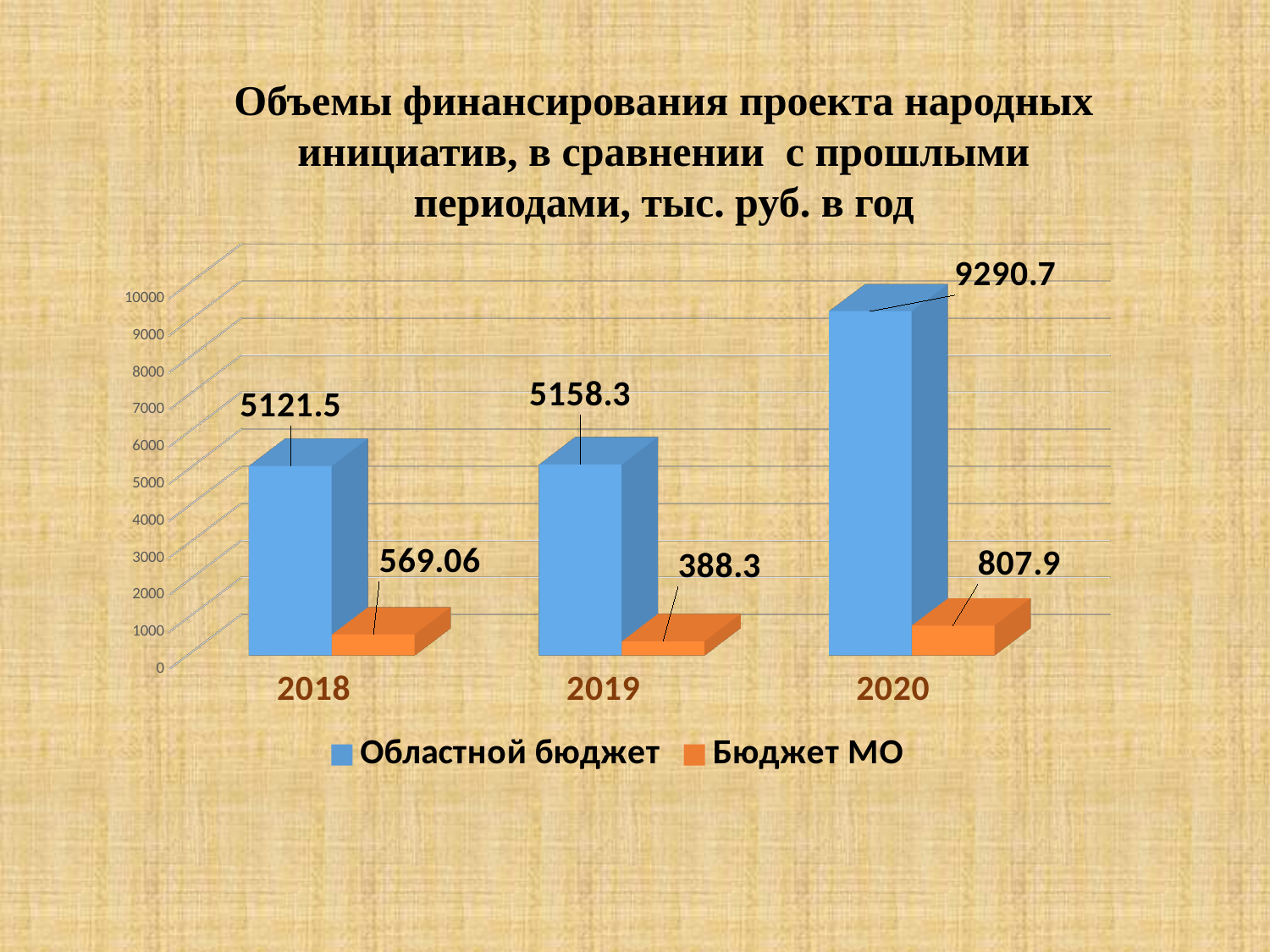
Which colour represents Бюджет МО in the chart? Orange What kind of chart is shown on the slide? Bar chart Which year has the highest value for Областной бюджет? 2020 What is the value for Бюджет МО in 2020? 807.9 What is the value for Бюджет МО in 2019? 388.3 What is the value for Областной бюджет in 2020? 9290.7 Which year has the lowest value for Бюджет МО? 2019 What is the difference between the Областной бюджет values for 2020 and 2019? 4132.4 How many years are shown on the x axis? 3 Which is larger: Бюджет МО in 2018 or Бюджет МО in 2020? Бюджет МО in 2020 What is the value for Областной бюджет in 2018? 5121.5 How many series does the legend list? 2